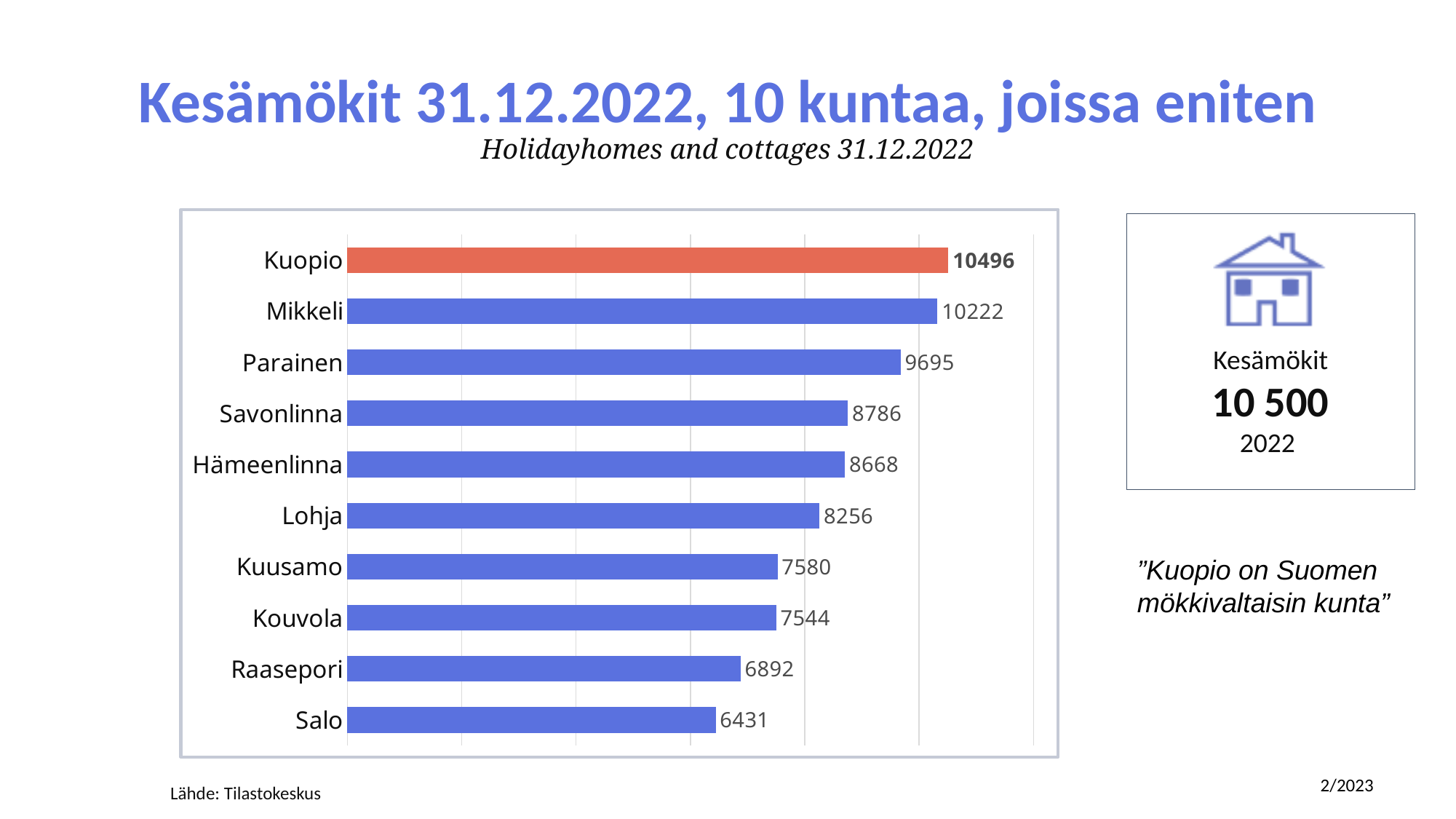
Which bar is coloured differently from the others? Kuopio What kind of chart is shown on the slide? bar chart What is the value for Raasepori? 6892 What is the difference between the values for Kuopio and Mikkeli? 274 What is the value for Kouvola? 7544 How many municipalities are shown in the chart? 10 What is the value for Savonlinna? 8786 Which municipality has the lowest value? Salo What is the difference between the values for Lohja and Salo? 1825 Which municipality has the highest value? Kuopio Which is larger, the value for Parainen or the value for Hämeenlinna? Parainen What is the value for Kuopio? 10496